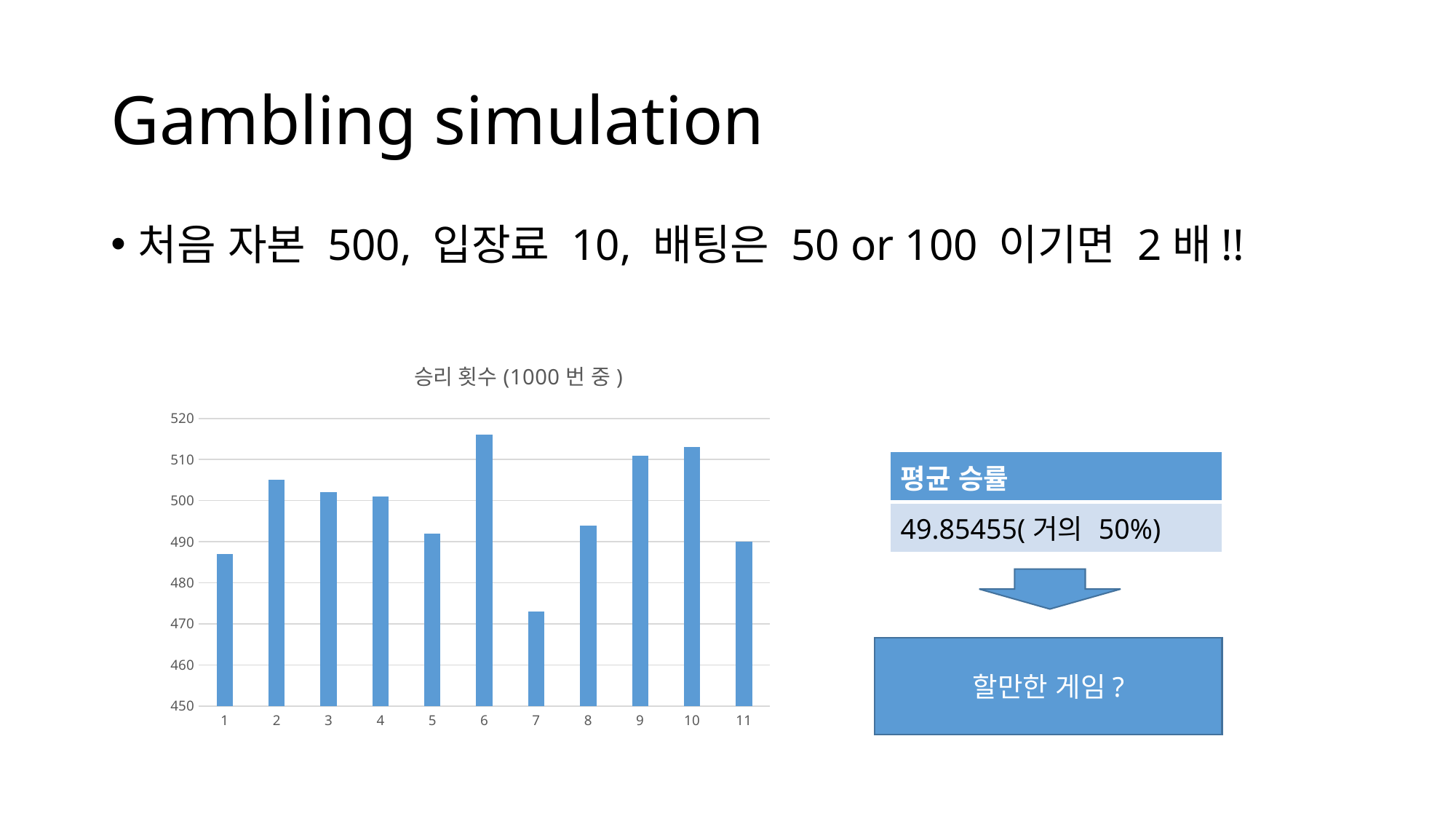
Is the value for category 2 greater or less than 500? greater What is the title of the chart? 승리 횟수 (1000 번 중 ) Is the value for category 6 greater or less than 510? greater Is the value for category 7 greater or less than 480? less Which category has the lowest value in the chart? 7 Which is larger, the value for category 6 or the value for category 7? 6 Which is larger, the value for category 2 or the value for category 5? 2 What kind of chart is shown on the slide? bar chart How many bars (categories) are plotted in the chart? 11 Which is larger, the value for category 1 or the value for category 10? 10